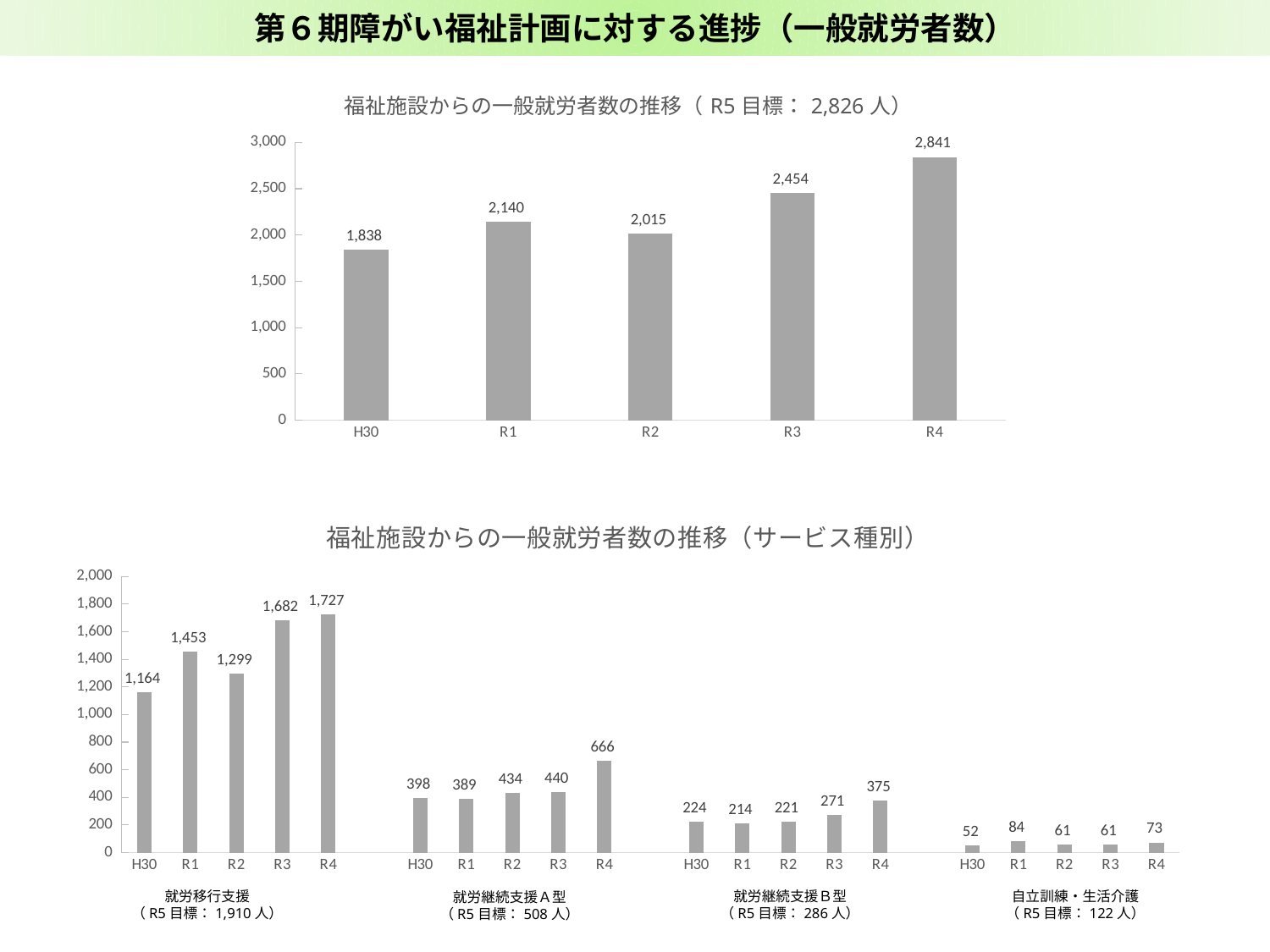
In the bottom chart (サービス種別), what is the R4 value for 就労継続支援Ａ型? 666 In the top chart (福祉施設からの一般就労者数の推移), which is larger, the value for R1 or the value for R2? R1 What kind of chart is the top chart (福祉施設からの一般就労者数の推移)? Bar chart In the top chart (福祉施設からの一般就労者数の推移), what is the value for H30? 1,838 In the bottom chart (サービス種別), what is the difference between the R4 and R3 values for 就労継続支援Ｂ型? 104 In the top chart (福祉施設からの一般就労者数の推移), which year has the lowest value? H30 In the top chart (福祉施設からの一般就労者数の推移), what is the value for R4? 2,841 In the top chart (福祉施設からの一般就労者数の推移), how many years are plotted? 5 According to the top chart's title, what is the R5 target (R5目標) for the number of general employment workers from welfare facilities? 2,826人 In the bottom chart (サービス種別), which year has the highest value for 就労移行支援? R4 In the top chart (福祉施設からの一般就労者数の推移), what is the difference between the R4 value and the R3 value? 387 In the bottom chart (サービス種別), what is the H30 value for 自立訓練・生活介護? 52